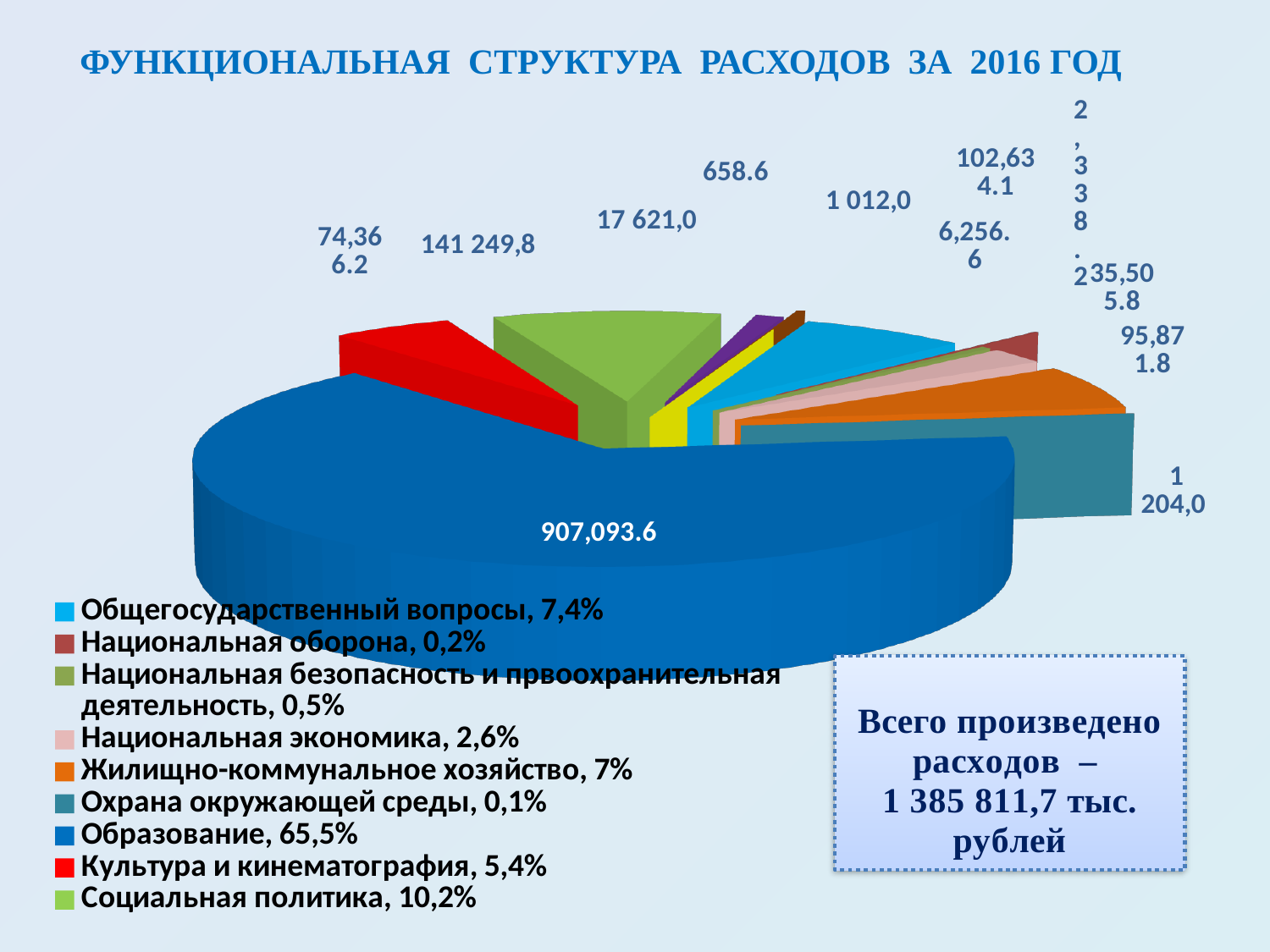
What kind of chart is shown on the slide? pie chart What data label is printed on the largest (Образование) slice of the pie chart? 907,093.6 How many categories does the legend of the pie chart list? 9 What share of expenditures does Общегосударственные вопросы account for? 7,4% What share of expenditures does Культура и кинематография account for? 5,4% Which category has the largest share of expenditures in the pie chart? Образование By how many percentage points does the share of Образование exceed the share of Социальная политика? 55,3% What share of expenditures does Образование account for? 65,5% Which has the larger share: Жилищно-коммунальное хозяйство or Общегосударственные вопросы? Общегосударственные вопросы According to the text box on the slide, what is the total amount of expenditures produced? 1 385 811,7 тыс. рублей